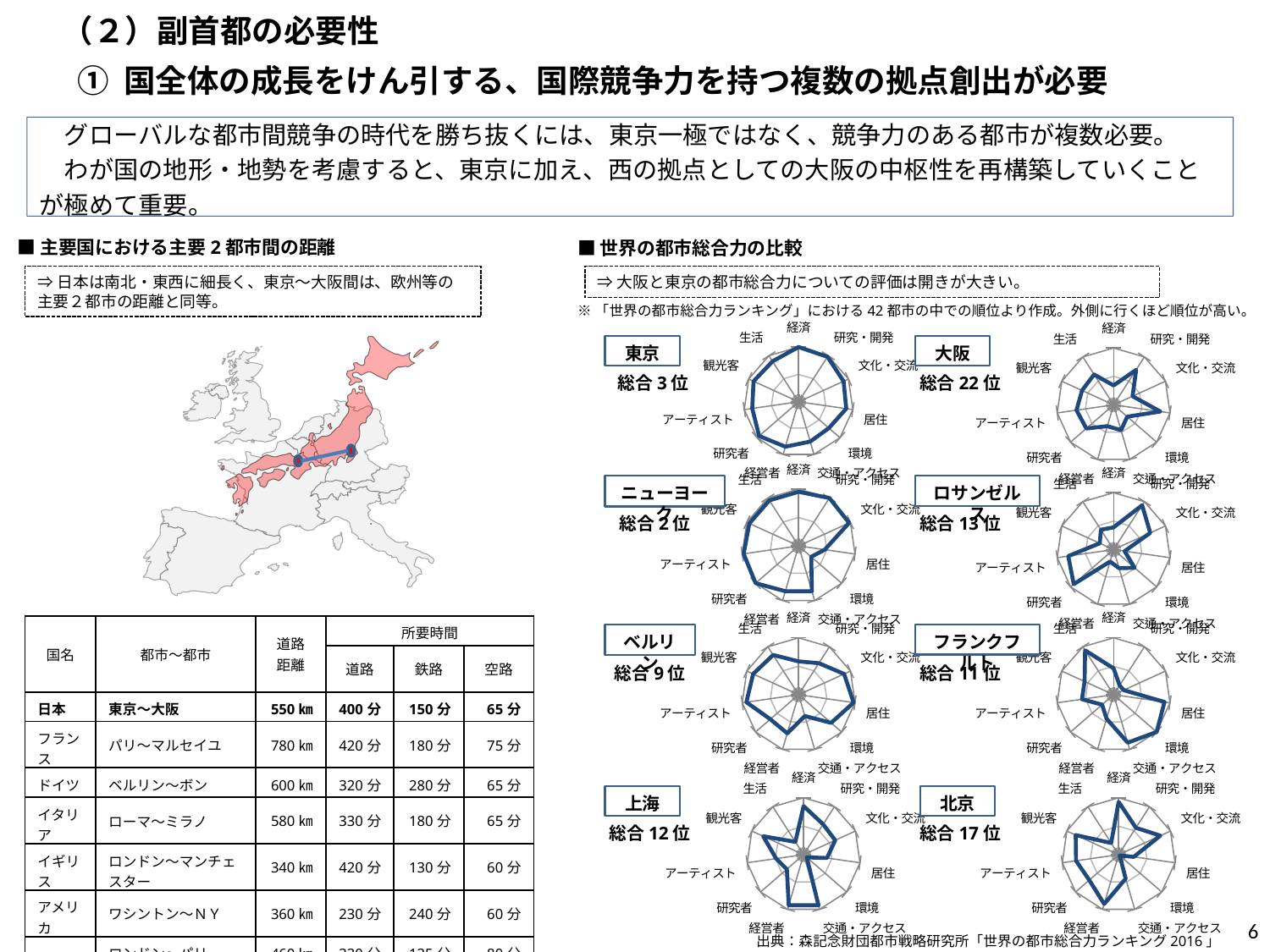
In the 「世界の都市総合力の比較」 section, what overall rank (総合) is shown for 北京? 総合 17 位 In the 「世界の都市総合力の比較」 section, what overall rank (総合) is shown for 東京? 総合 3 位 In the 「世界の都市総合力の比較」 section, which city has the best (highest) overall rank? ニューヨーク In the 「世界の都市総合力の比較」 section, which city has a better overall rank, 上海 or 北京? 上海 In the 「世界の都市総合力の比較」 section, what overall rank (総合) is shown for ニューヨーク? 総合 2 位 According to the note above the radar charts, how many cities are in the ranking the charts are based on? 42 都市 In the 「世界の都市総合力の比較」 section, what overall rank (総合) is shown for ロサンゼルス? 総合 13 位 In the 「世界の都市総合力の比較」 section, what overall rank (総合) is shown for 大阪? 総合 22 位 What kind of chart is used in the 「世界の都市総合力の比較」 section to show each city's rankings? radar chart In the 「世界の都市総合力の比較」 section, which city has the worst (lowest) overall rank? 大阪 In the 「世界の都市総合力の比較」 section, which city's radar polygon extends further toward the outer edge, 東京 or 大阪? 東京 How many radar charts are shown in the 「世界の都市総合力の比較」 section? 8